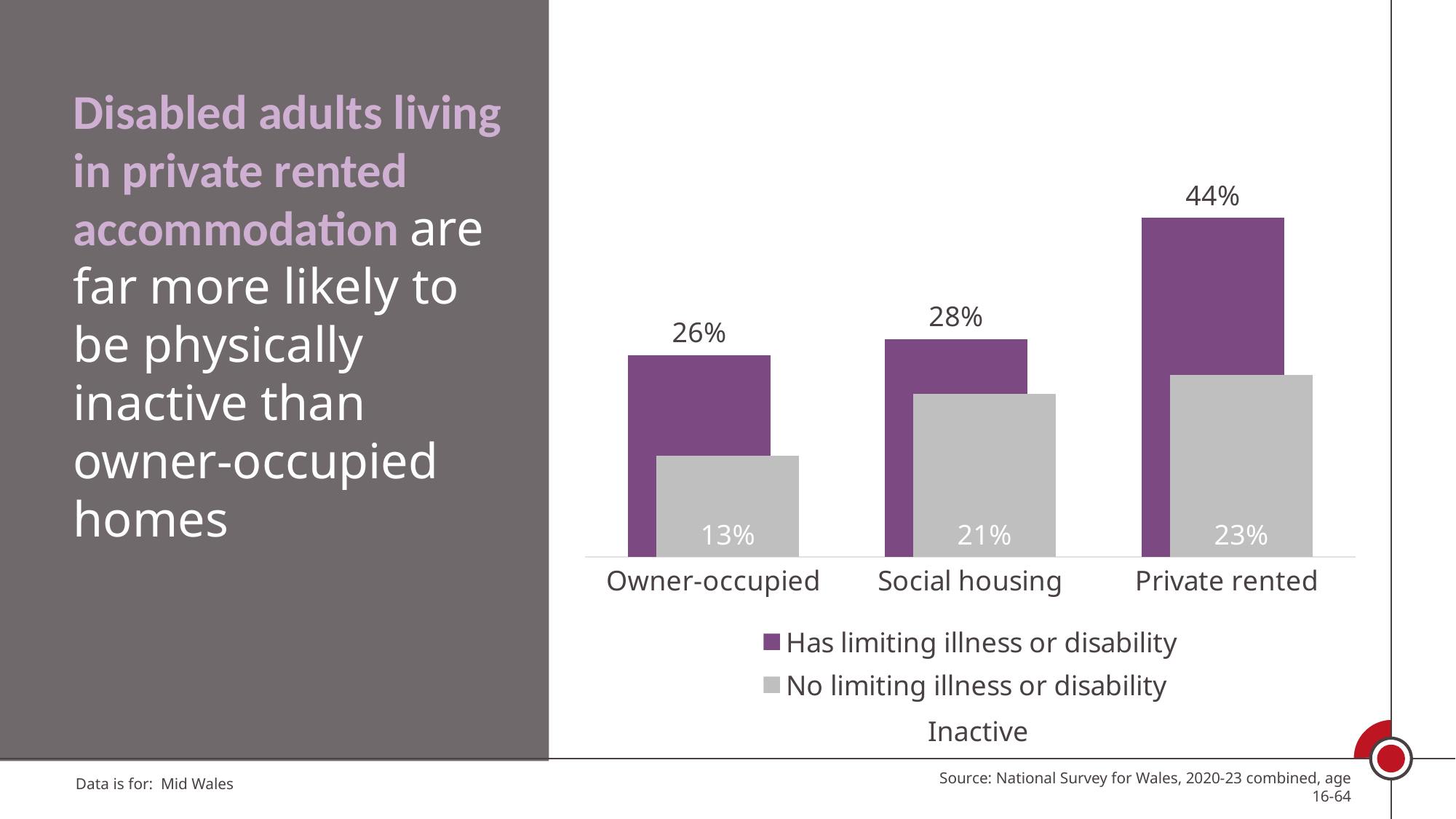
How many series does the legend list? 2 What is the value for Social housing in the 'No limiting illness or disability' series? 21% Which category has the highest value for 'Has limiting illness or disability'? Private rented Which category has the lowest value for 'No limiting illness or disability'? Owner-occupied How many categories are shown on the x axis? 3 What is the difference between the 'Has limiting illness or disability' and 'No limiting illness or disability' values for Private rented? 21% Which is larger: the 'No limiting illness or disability' value for Private rented or for Social housing? Private rented What is the difference between the 'Has limiting illness or disability' values for Private rented and Owner-occupied? 18% What is the value for Private rented in the 'Has limiting illness or disability' series? 44% What is the value for Social housing in the 'Has limiting illness or disability' series? 28% What kind of chart is shown on the slide? Bar chart What is the value for Owner-occupied in the 'No limiting illness or disability' series? 13%